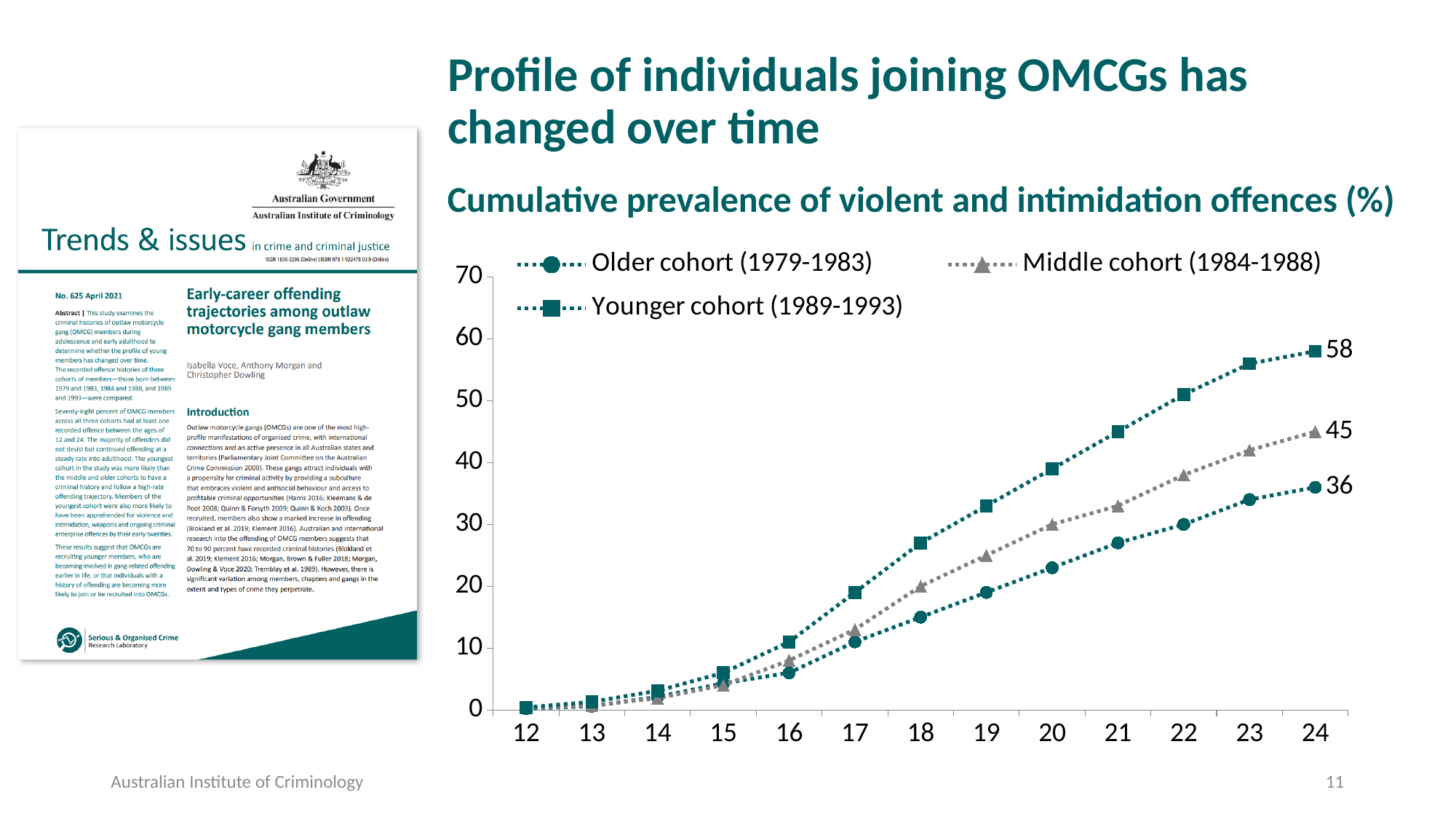
Do the values for each cohort rise or fall as age increases from 12 to 24? rise What is the value for the Younger cohort (1989-1993) at age 24? 58 Is the value for the Younger cohort at age 20 greater or less than 30? greater Is the value for the Older cohort at age 18 greater or less than 20? less Which cohort has the lowest cumulative prevalence at age 24? Older cohort (1979-1983) What kind of chart is shown on the slide? line chart What is the difference between the Younger cohort and the Older cohort values at age 24? 22 Which cohort has the highest cumulative prevalence at age 24? Younger cohort (1989-1993) How many age points are plotted along the x axis? 13 What is the value for the Middle cohort (1984-1988) at age 24? 45 How many series does the chart legend list? 3 What is the value for the Older cohort (1979-1983) at age 24? 36